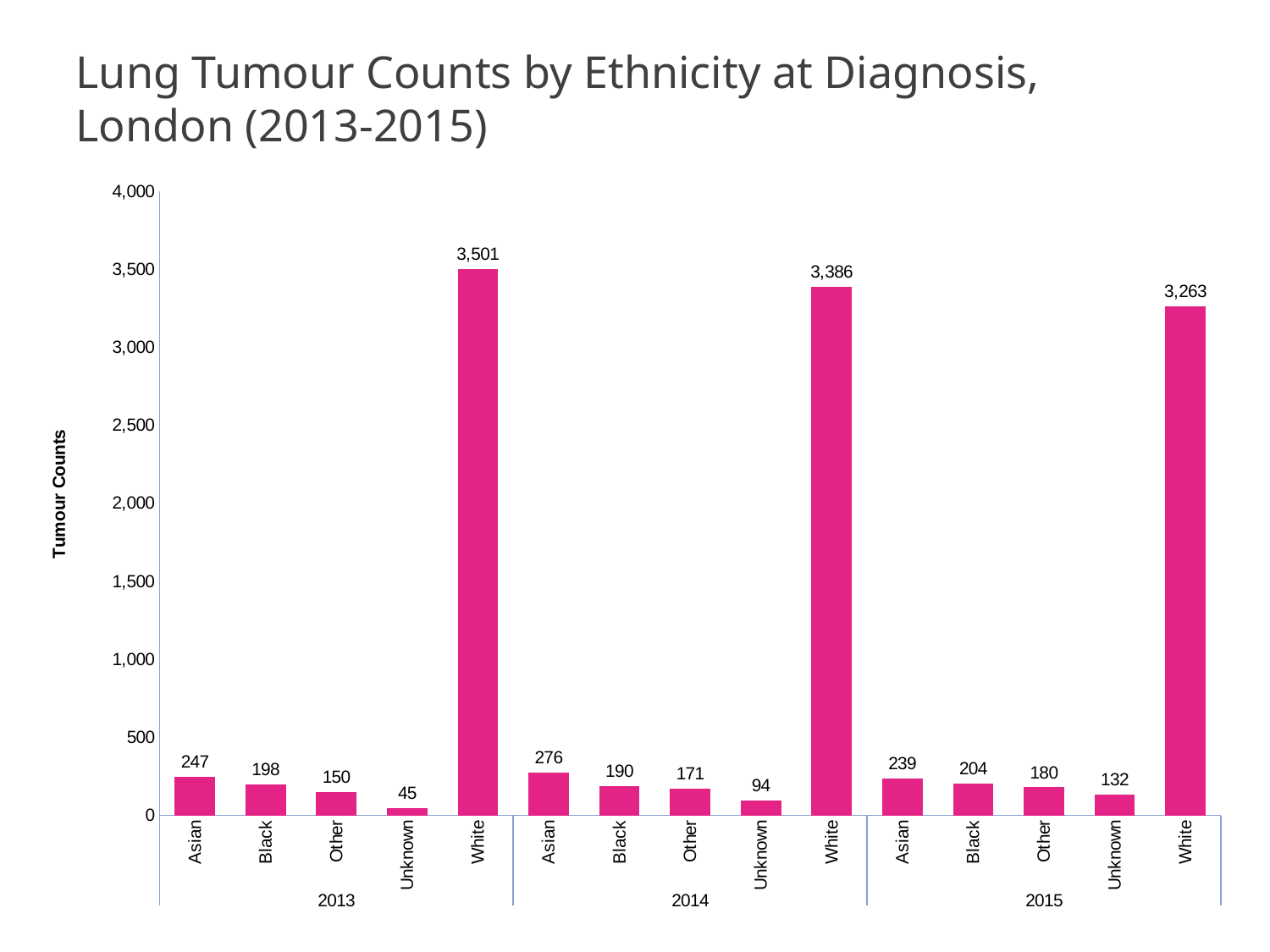
What is the difference between the White tumour counts in 2013 and 2015? 238 Do the White tumour counts rise or fall from 2013 to 2015? Fall What is the difference between the Black and Other tumour counts in 2014? 19 How many bars are plotted in the chart? 15 Which ethnicity has the lowest tumour count in 2013? Unknown What kind of chart is shown on the slide? Bar chart What is the lung tumour count for White patients in 2013? 3,501 What is the lung tumour count for Asian patients in 2015? 239 Which is larger, the Asian count in 2014 or the Asian count in 2013? Asian count in 2014 What is the lung tumour count for Unknown ethnicity in 2014? 94 Which ethnicity has the highest tumour count in 2015? White Is the White tumour count in 2014 greater or less than 3,500? less